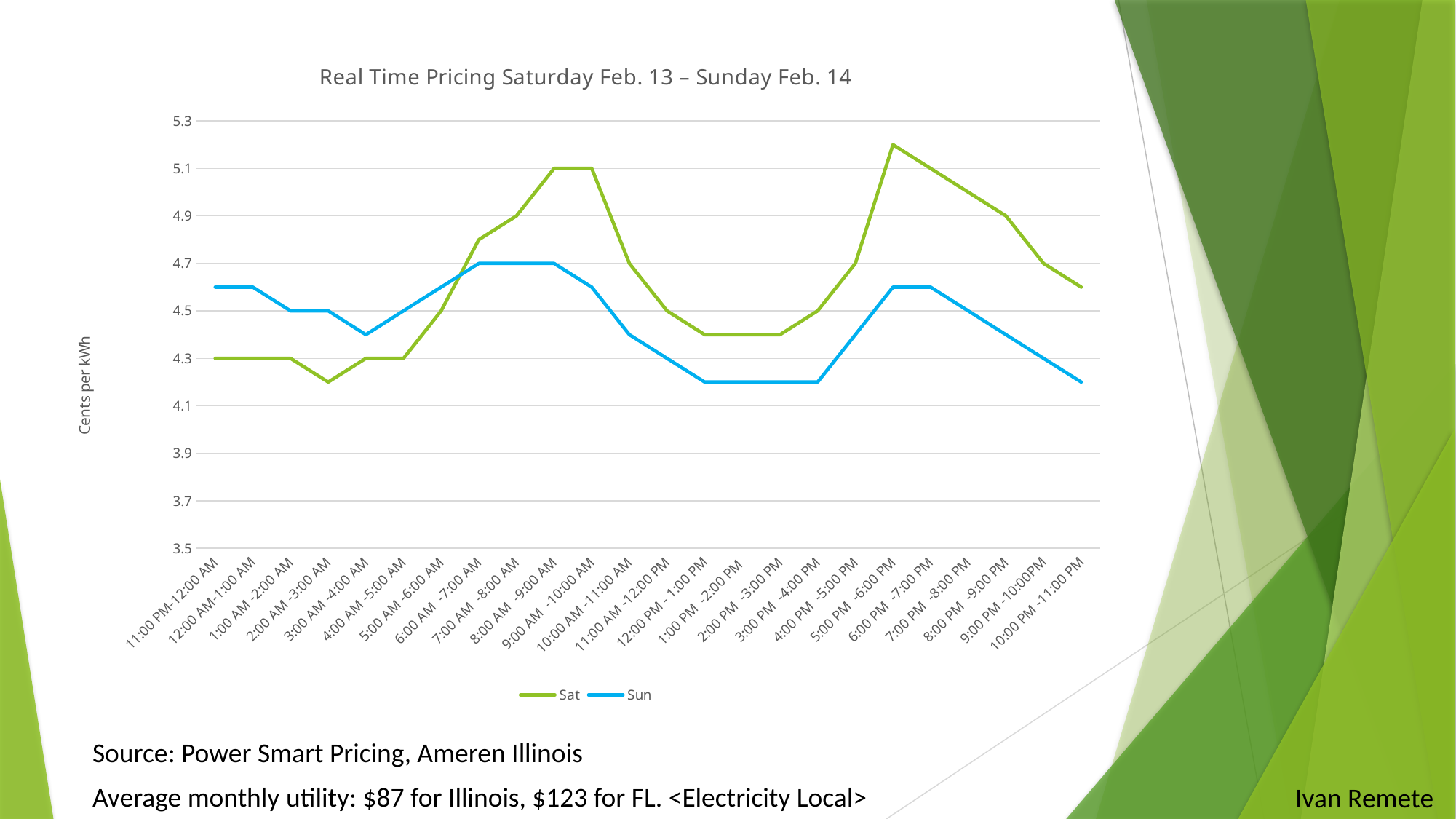
How many hourly time periods are plotted along the x axis? 24 What is the difference between the Sat and Sun values for 8:00 AM - 9:00 AM? 0.4 What is the Sat value for 8:00 AM - 9:00 AM? 5.1 Which series has the larger value for 12:00 AM - 1:00 AM, Sat or Sun? Sun Is the Sat value for 5:00 PM - 6:00 PM greater or less than 5.1? greater In which time period does the Sat series reach its highest value? 5:00 PM - 6:00 PM In which time period does the Sat series reach its lowest value? 2:00 AM - 3:00 AM How many series does the legend list? 2 What is the Sun value for 7:00 AM - 8:00 AM? 4.7 What kind of chart is shown on the slide? line chart What is the Sat value for 11:00 PM - 12:00 AM? 4.3 What is the label of the y axis? Cents per kWh